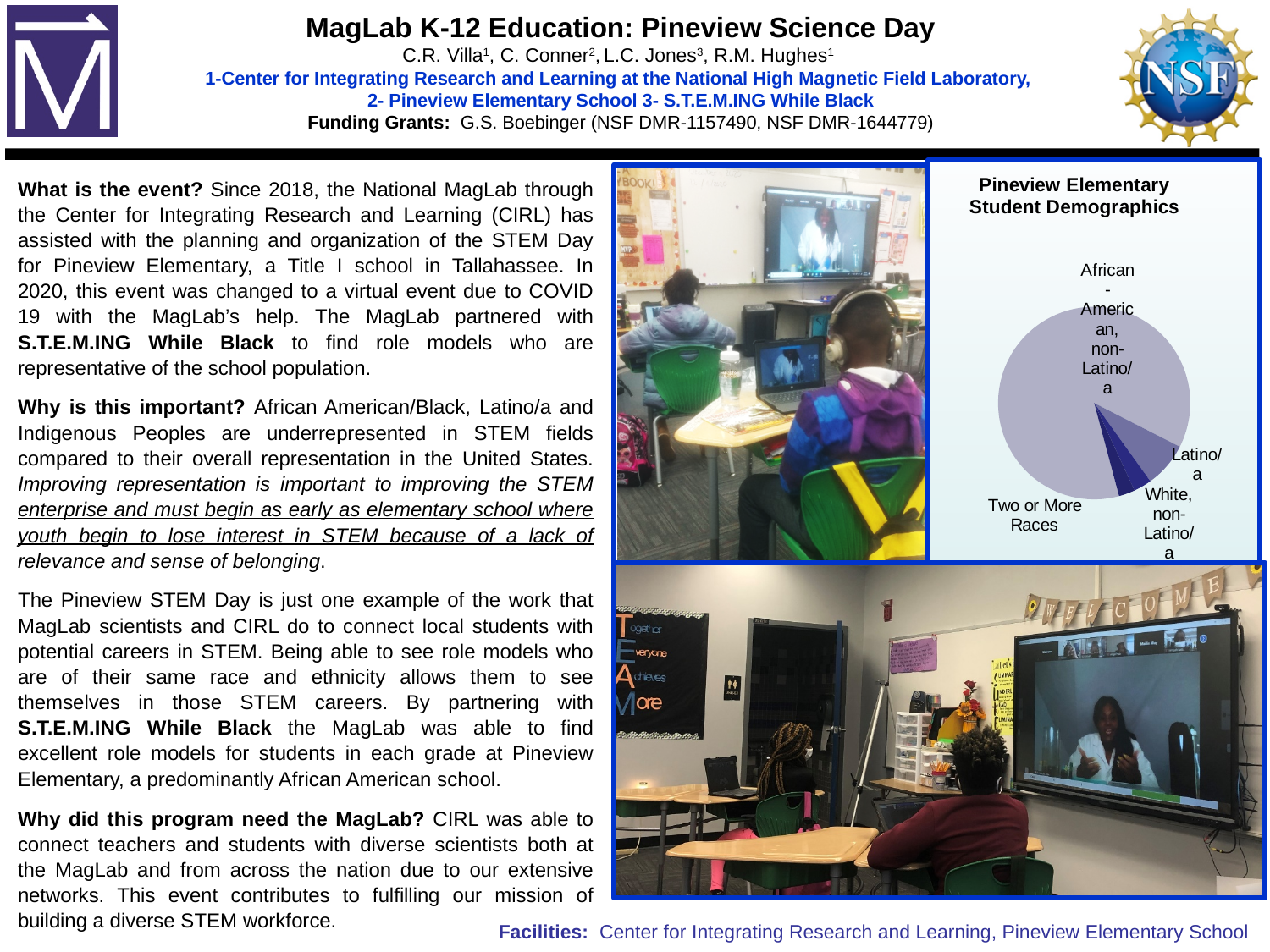
In the Pineview Elementary Student Demographics pie chart, which is larger: the African-American, non-Latino/a slice or the Latino/a slice? African-American, non-Latino/a What kind of chart is shown under the title "Pineview Elementary Student Demographics"? pie chart Which category has the largest slice in the Pineview Elementary Student Demographics pie chart? African-American, non-Latino/a What is the title of the chart on the slide? Pineview Elementary Student Demographics Does the African-American, non-Latino/a slice make up more or less than half of the Pineview Elementary Student Demographics pie chart? more In the Pineview Elementary Student Demographics pie chart, which is larger: the Latino/a slice or the White, non-Latino/a slice? Latino/a In the Pineview Elementary Student Demographics pie chart, which is larger: the African-American, non-Latino/a slice or the Two or More Races slice? African-American, non-Latino/a Which category is labeled at the lower left of the Pineview Elementary Student Demographics pie chart? Two or More Races How many categories (slices) does the Pineview Elementary Student Demographics pie chart show? 4